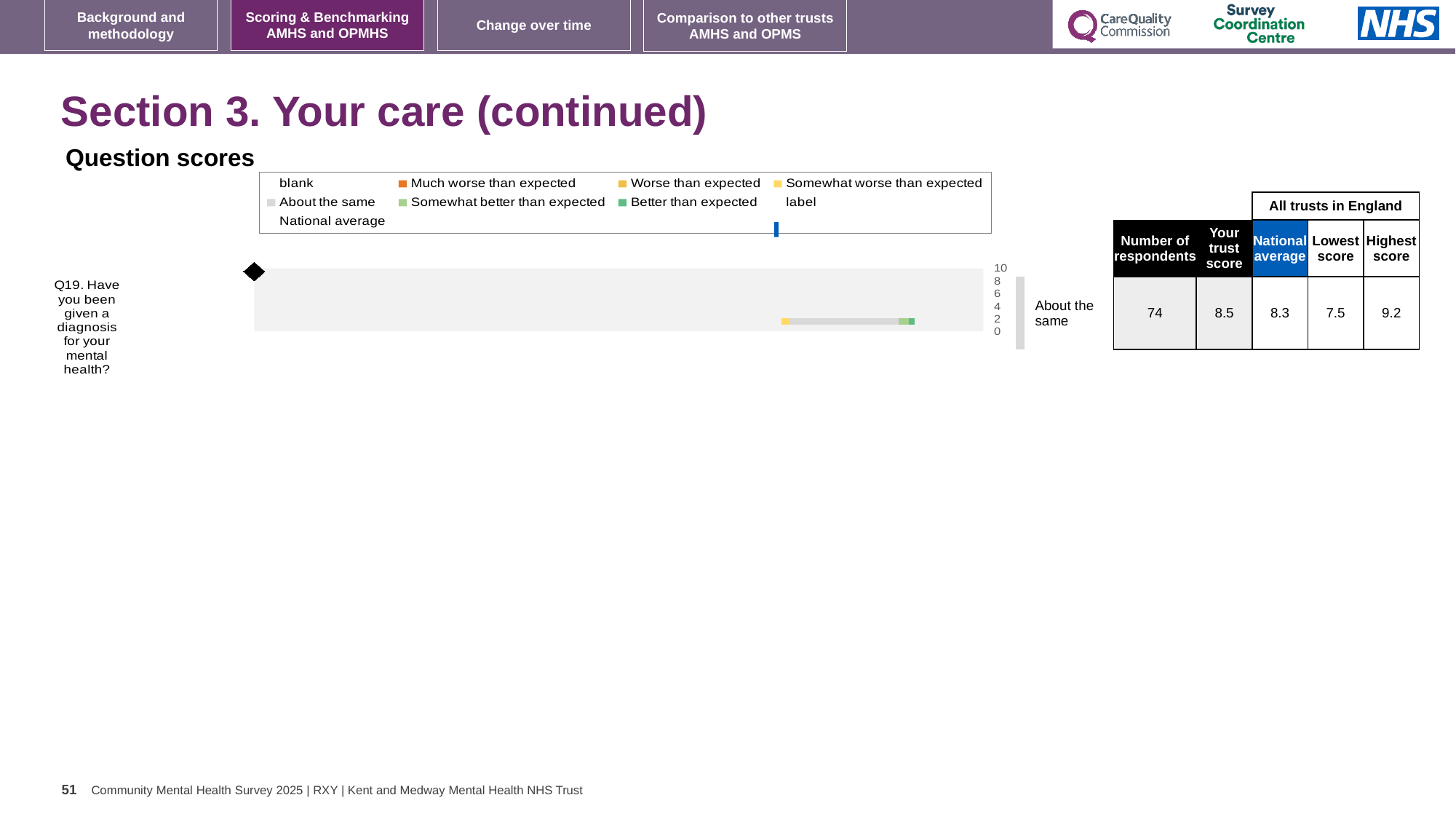
For Q19, which is larger: the trust's score or the national average? the trust's score What rating label is shown next to the bar for Q19 in the question scores chart? About the same In the table beside the chart, what is the number of respondents for Q19? 74 In the table beside the chart, what is the trust's score for Q19? 8.5 How many questions are plotted in the question scores chart? 1 In the table beside the chart, what is the highest score among all trusts in England for Q19? 9.2 In the table beside the chart, what is the national average for Q19? 8.3 For Q19, what is the difference between the trust's score and the national average? 0.2 Which question is plotted in the question scores chart? Q19. Have you been given a diagnosis for your mental health? For Q19, what is the difference between the highest and lowest scores among all trusts in England? 1.7 In the table beside the chart, what is the lowest score among all trusts in England for Q19? 7.5 What kind of chart is used to show the question scores on this slide? bar chart